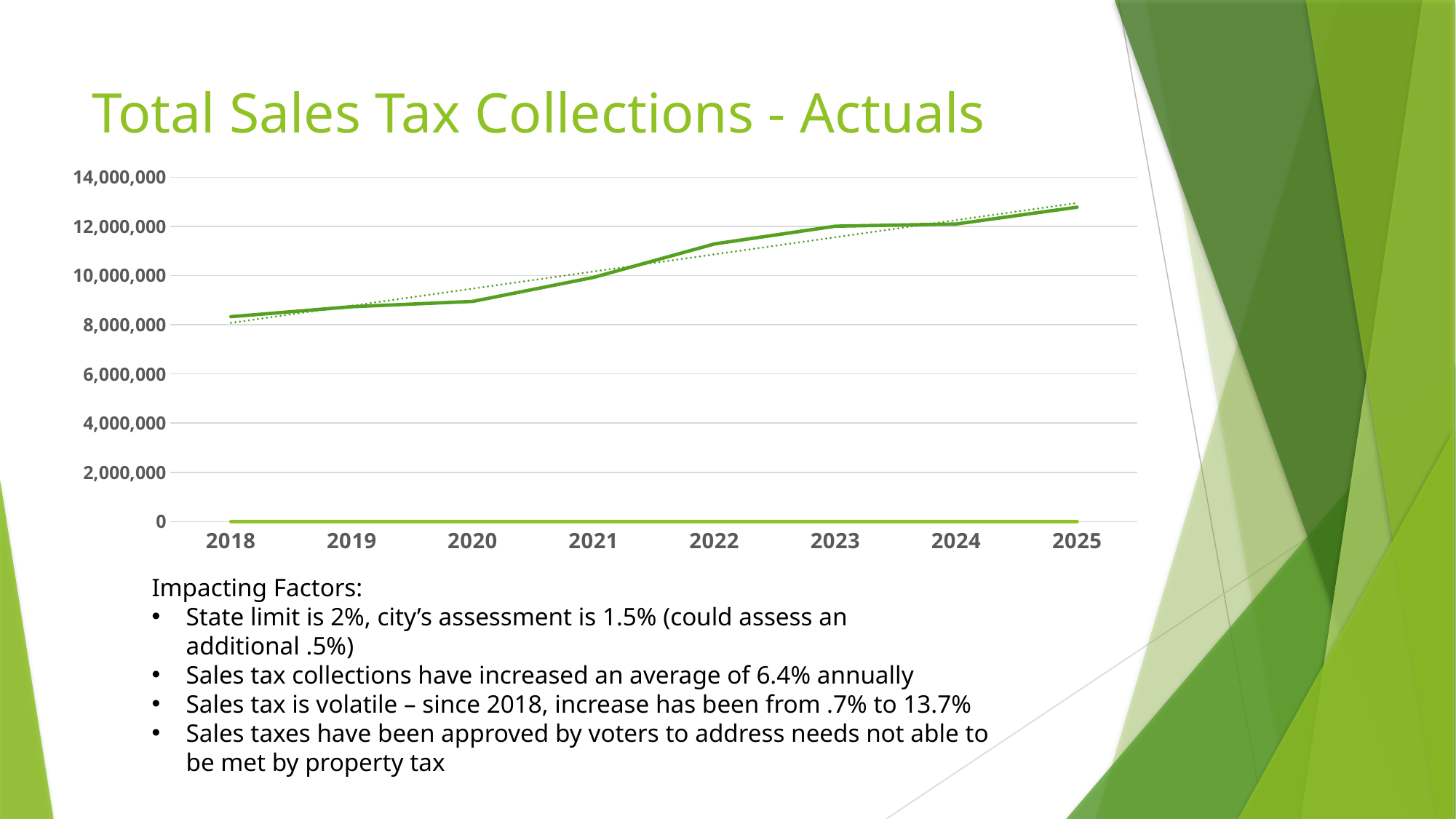
What is the title of the slide containing the chart? Total Sales Tax Collections - Actuals Which year has larger sales tax collections, 2018 or 2025? 2025 What is the highest value shown on the y axis of the chart? 14,000,000 Is the value for 2022 greater or less than 10,000,000? greater What kind of chart is shown on the slide? line chart Which year has the lowest sales tax collections? 2018 Do the sales tax collections rise or fall from 2018 to 2025? rise Is the value for 2020 greater or less than 10,000,000? less Is the value for 2018 greater or less than 10,000,000? less How many years are shown on the x axis of the chart? 8 Which year has the highest sales tax collections? 2025